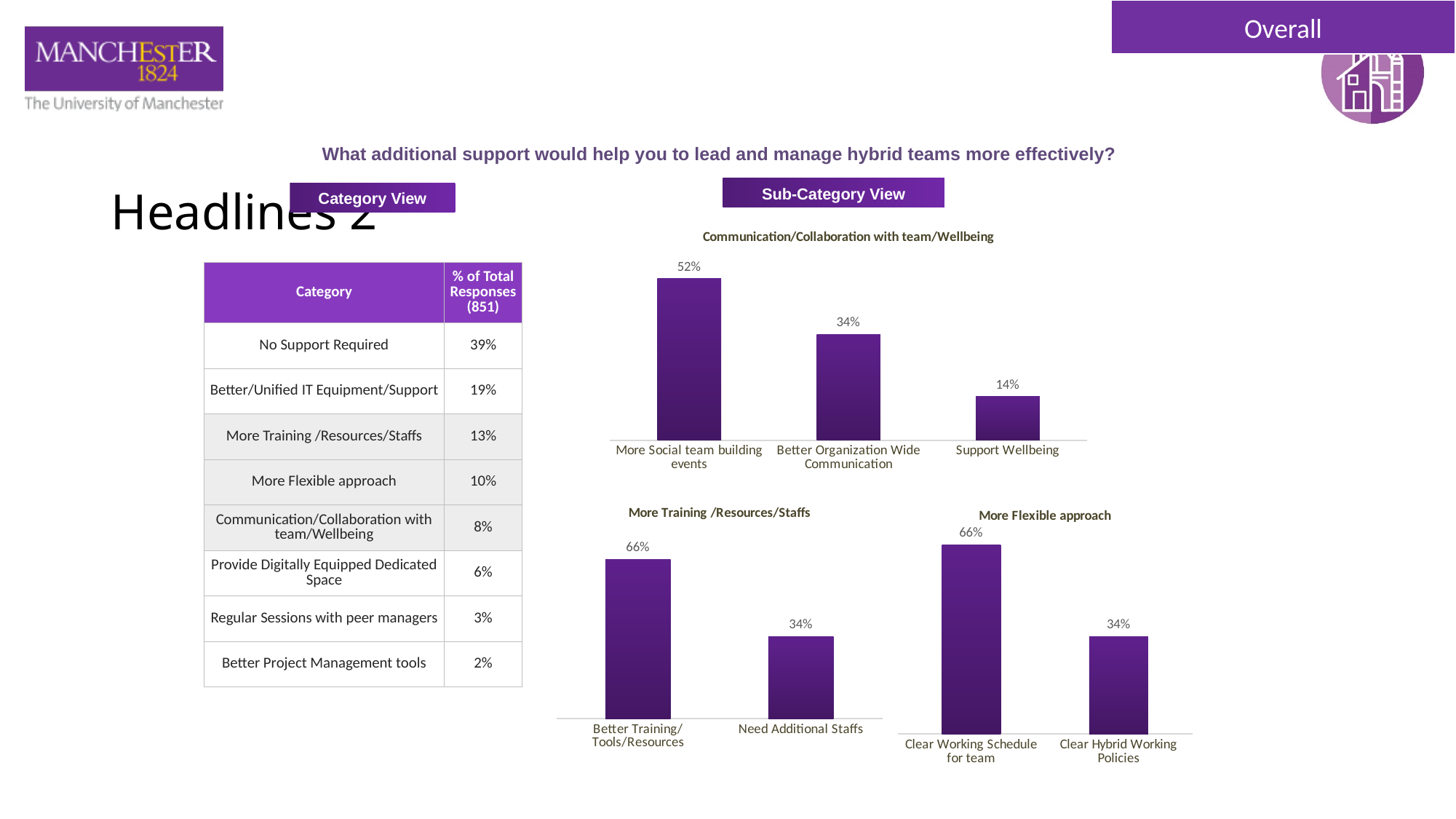
In the "More Flexible approach" chart, what is the difference between Clear Working Schedule for team and Clear Hybrid Working Policies? 32% What type of chart is the "More Flexible approach" chart? Bar chart In the "Communication/Collaboration with team/Wellbeing" chart, what is the value for Support Wellbeing? 14% In the "Communication/Collaboration with team/Wellbeing" chart, what is the difference between More Social team building events and Better Organization Wide Communication? 18% In the "More Flexible approach" chart, what is the value for Clear Hybrid Working Policies? 34% How many categories are shown in the "Communication/Collaboration with team/Wellbeing" chart? 3 In the "More Training /Resources/Staffs" chart, what is the value for Need Additional Staffs? 34% In the "Communication/Collaboration with team/Wellbeing" chart, which category has the lowest value? Support Wellbeing In the "More Training /Resources/Staffs" chart, what is the value for Better Training/Tools/Resources? 66% In the "Communication/Collaboration with team/Wellbeing" chart, what is the value for More Social team building events? 52% In the "More Training /Resources/Staffs" chart, which is larger: Better Training/Tools/Resources or Need Additional Staffs? Better Training/Tools/Resources In the "Communication/Collaboration with team/Wellbeing" chart, which category has the highest value? More Social team building events